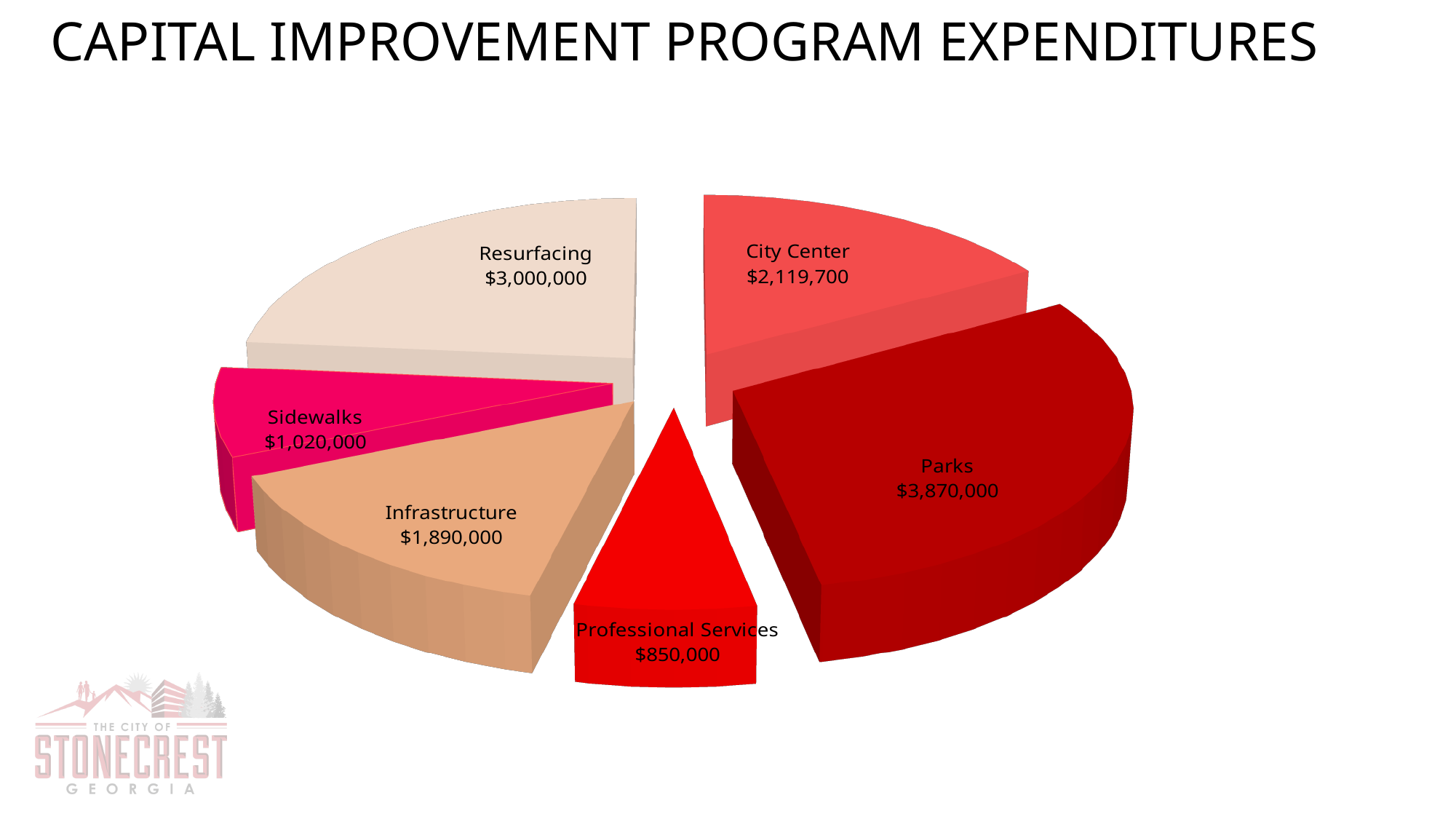
Which category has the smallest expenditure? Professional Services What is the expenditure for Parks? $3,870,000 What type of chart is shown on the slide? Pie chart Which category has the largest expenditure? Parks What is the expenditure for Professional Services? $850,000 What is the expenditure for City Center? $2,119,700 What is the difference between the Resurfacing and Infrastructure expenditures? $1,110,000 Which is larger, the expenditure for Infrastructure or for City Center? City Center How many categories are shown in the pie chart? 6 What is the expenditure for Sidewalks? $1,020,000 What is the difference between the Parks and Resurfacing expenditures? $870,000 What is the title of the chart? CAPITAL IMPROVEMENT PROGRAM EXPENDITURES